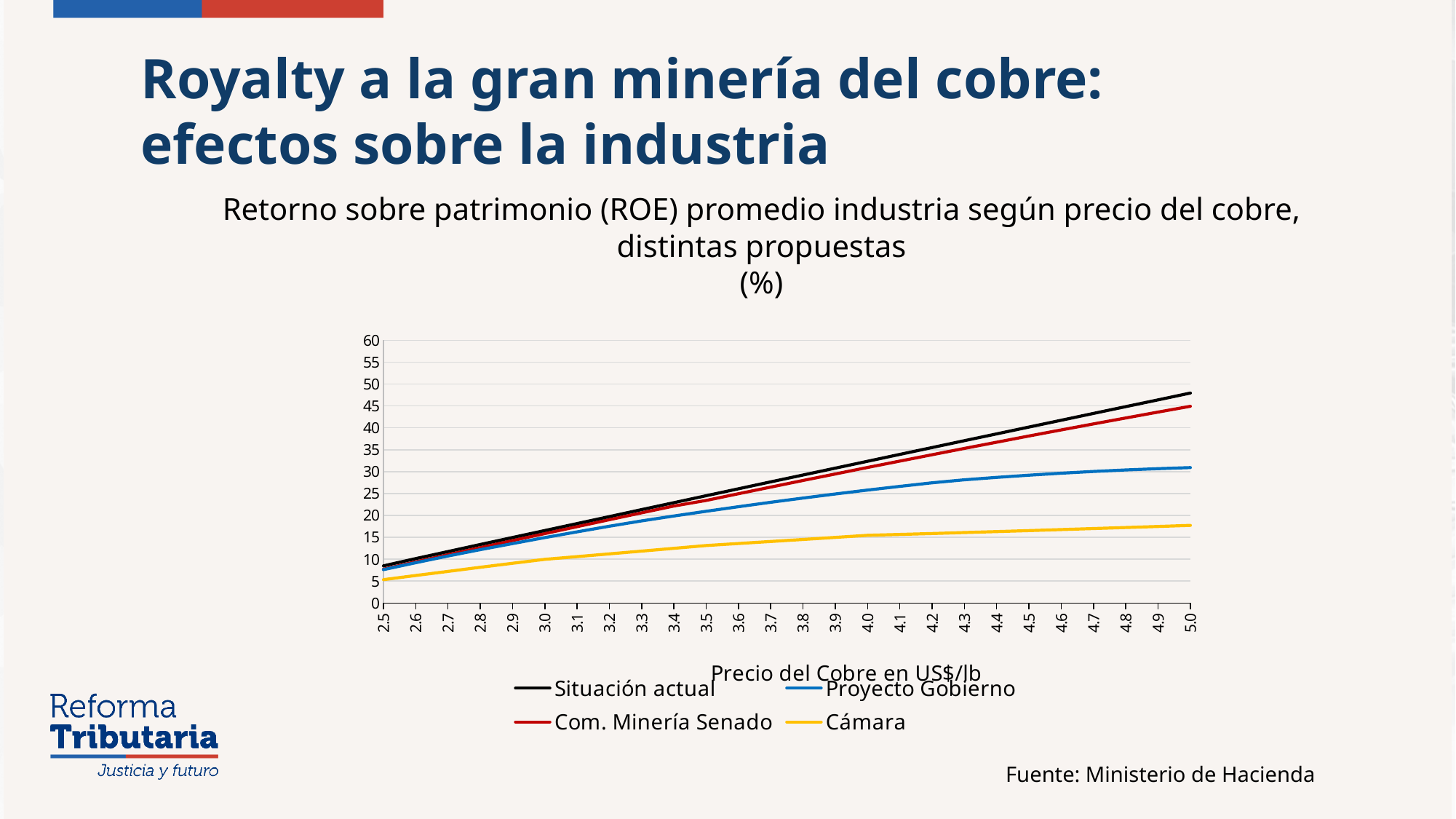
At a copper price of 4.0, which is larger: Proyecto Gobierno or Cámara? Proyecto Gobierno Which series has the highest value at a copper price of 5.0? Situación actual Does the Situación actual line rise or fall as the copper price increases? rise What is the title of the x axis? Precio del Cobre en US$/lb Which series has the lowest value at a copper price of 5.0? Cámara Is the value for Cámara at a copper price of 5.0 greater or less than 20? less How many series does the legend list? 4 What kind of chart is shown on the slide? line chart Is the value for Proyecto Gobierno at a copper price of 5.0 greater or less than 25? greater What colour is the Cámara line in the legend? yellow Is the value for Situación actual at a copper price of 5.0 greater or less than 45? greater How many copper price points are shown along the x axis? 26